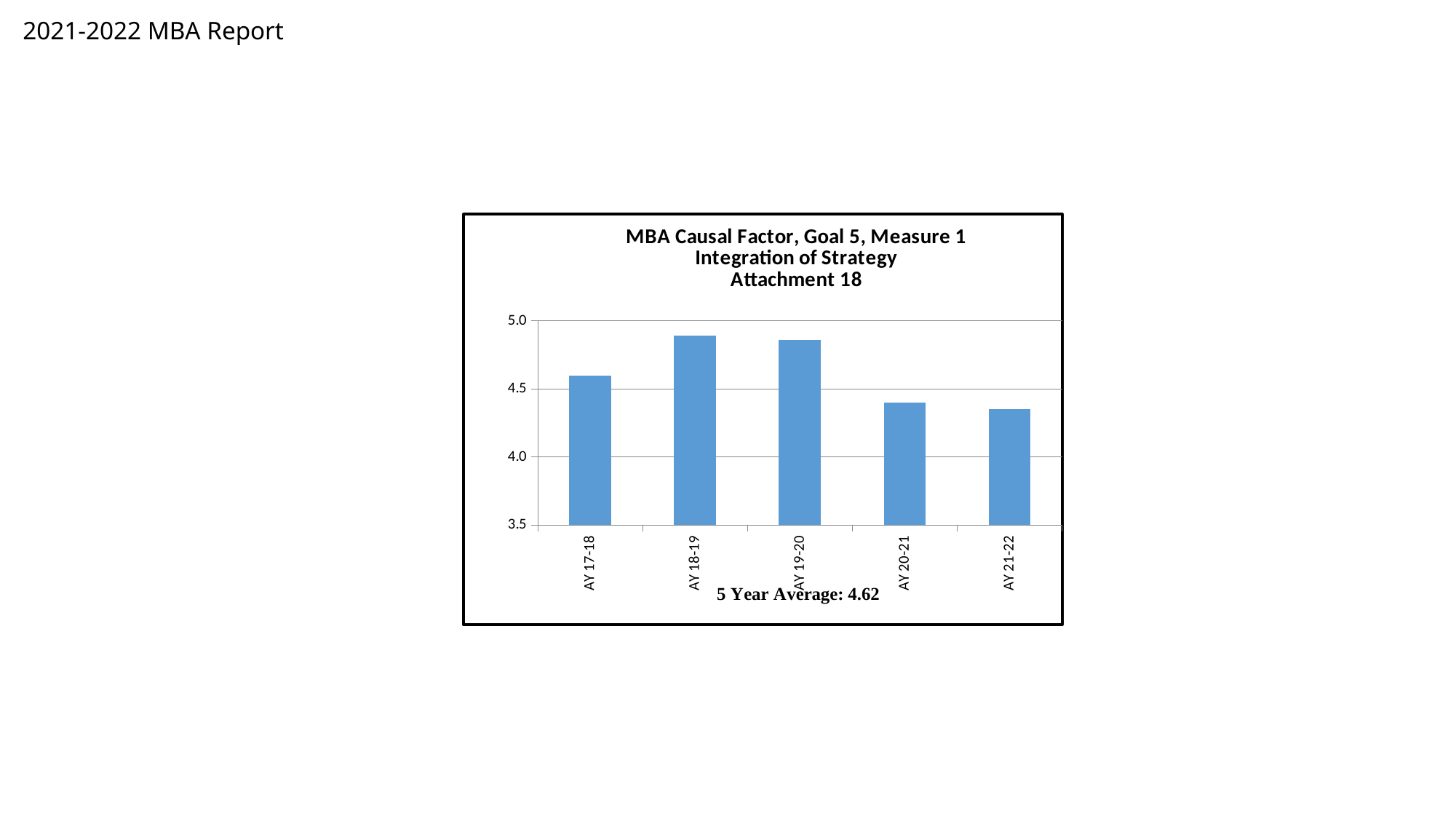
What is the 5 year average stated on the chart? 4.62 Is the value for AY 17-18 greater or less than 4.5? greater Is the value for AY 20-21 greater or less than 4.5? less Do the values rise or fall from AY 19-20 to AY 21-22? fall How many academic years are plotted in the chart? 5 What is the title of the chart? MBA Causal Factor, Goal 5, Measure 1 Integration of Strategy Attachment 18 Which has the larger value, AY 18-19 or AY 20-21? AY 18-19 Is the value for AY 21-22 greater or less than 4.5? less Which has the larger value, AY 17-18 or AY 21-22? AY 17-18 What kind of chart is shown on the slide? bar chart